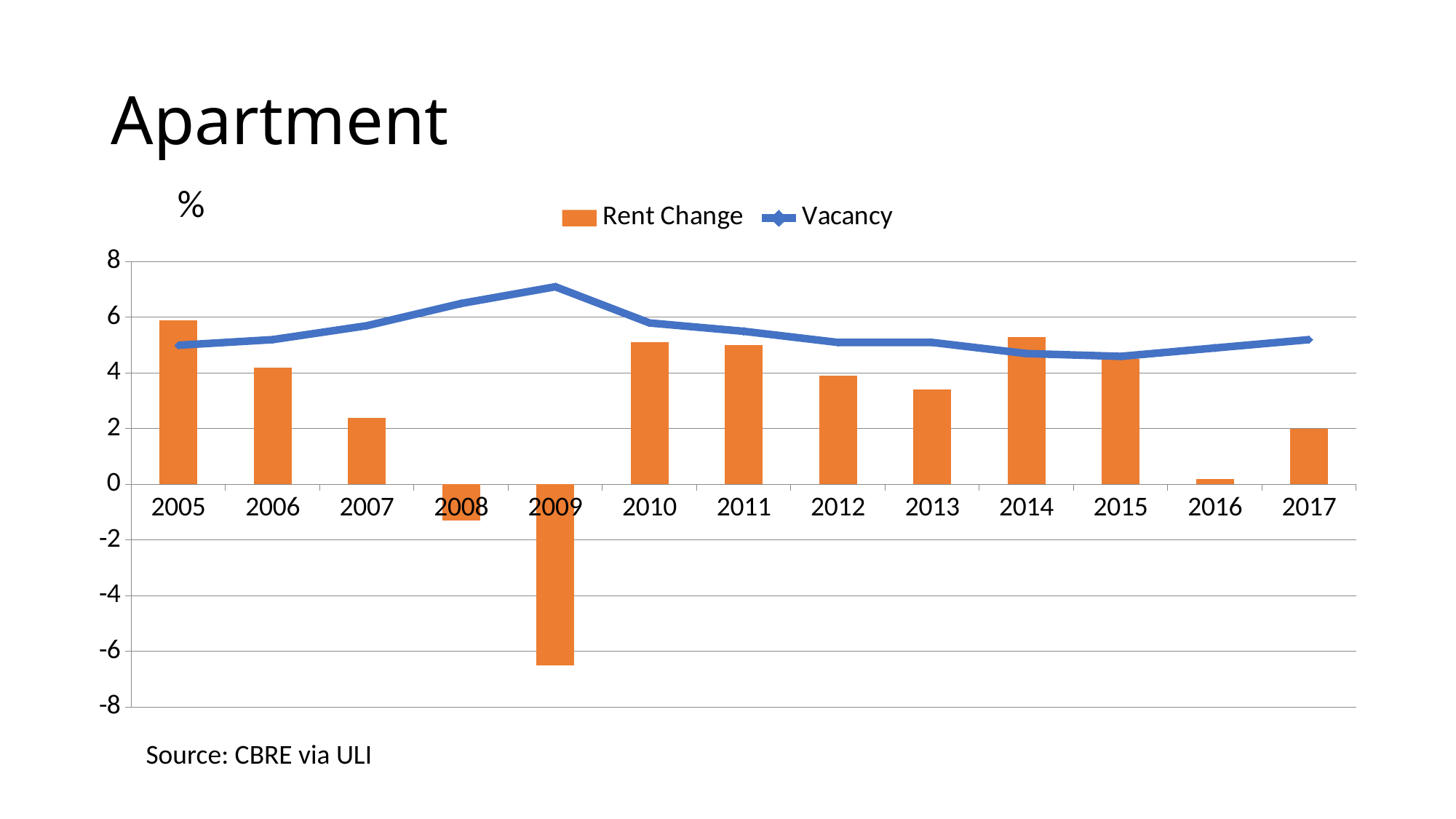
In which year does the Vacancy line reach its highest point? 2009 Which year has the lowest Rent Change? 2009 Which year has the larger Rent Change, 2006 or 2007? 2006 Is the Rent Change value for 2009 greater or less than -6? less Which year has the highest Rent Change? 2005 Does the Vacancy line rise or fall from 2005 to 2009? rise Is the Rent Change value for 2016 greater or less than 2? less Which series is shown as orange bars in the chart? Rent Change What kind of chart is shown on the slide? Combination bar and line chart How many series does the chart legend list? 2 Is the Vacancy value for 2009 greater or less than 6? greater How many years are shown on the x axis of the chart? 13